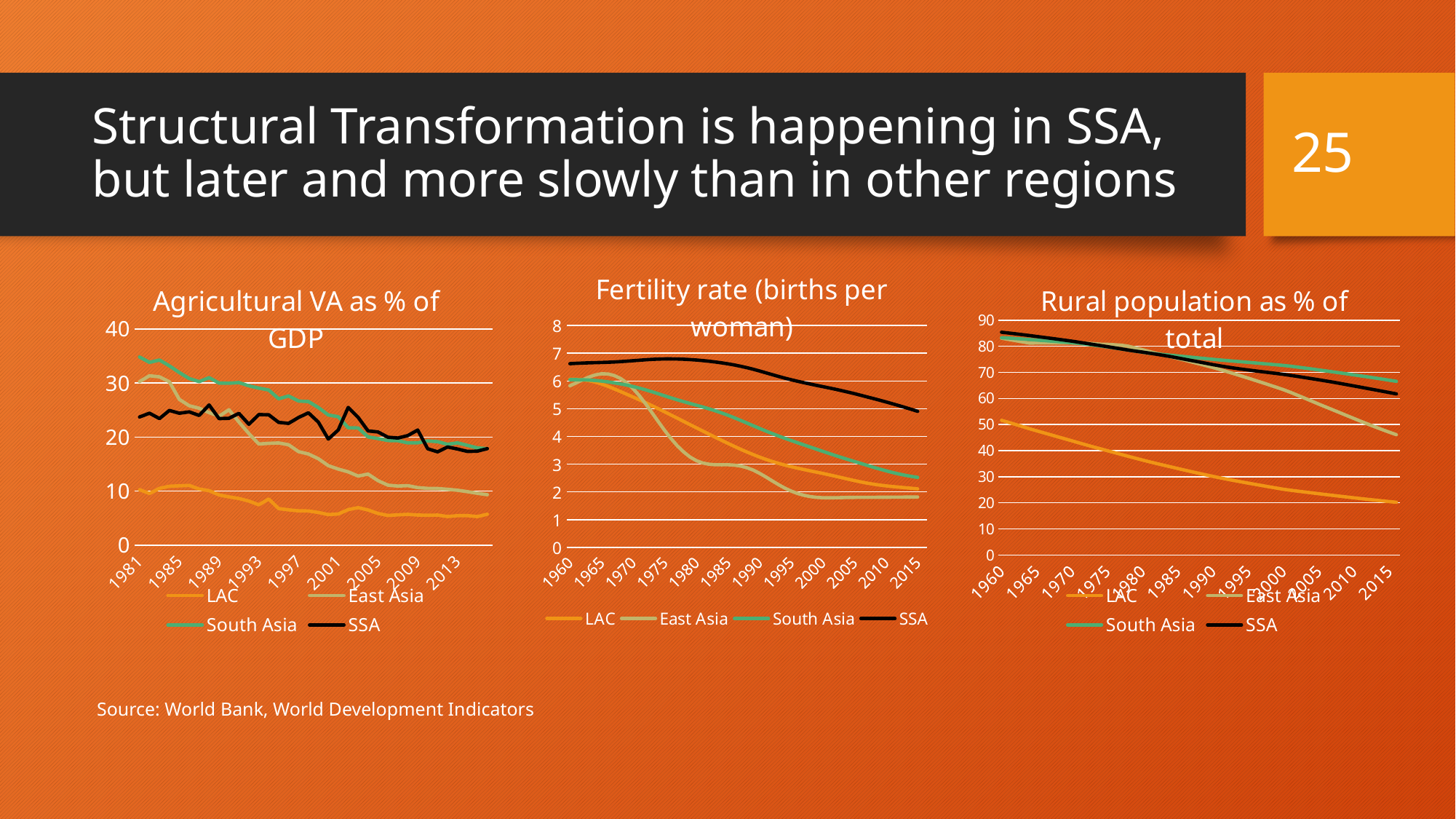
In the "Fertility rate (births per woman)" chart, how many series does the legend list? 4 In the "Fertility rate (births per woman)" chart, is the SSA value in 2015 greater or less than 4? greater What kind of chart is the "Agricultural VA as % of GDP" chart? line chart In the "Agricultural VA as % of GDP" chart, which region has the highest value in 1981? South Asia In the "Fertility rate (births per woman)" chart, which is larger in 2015, SSA or East Asia? SSA In the "Rural population as % of total" chart, does the SSA line rise or fall from 1960 to 2015? fall In the "Rural population as % of total" chart, is the LAC value in 1960 greater or less than 40? greater In the "Fertility rate (births per woman)" chart, does the East Asia line rise or fall from 1960 to 2015? fall In the "Rural population as % of total" chart, which region has the lowest value in 2015? LAC What series does the legend of the "Agricultural VA as % of GDP" chart list? LAC, East Asia, South Asia, SSA In the "Rural population as % of total" chart, which region has the highest value in 2015? South Asia In the "Agricultural VA as % of GDP" chart, is the LAC value in 2013 greater or less than 10? less